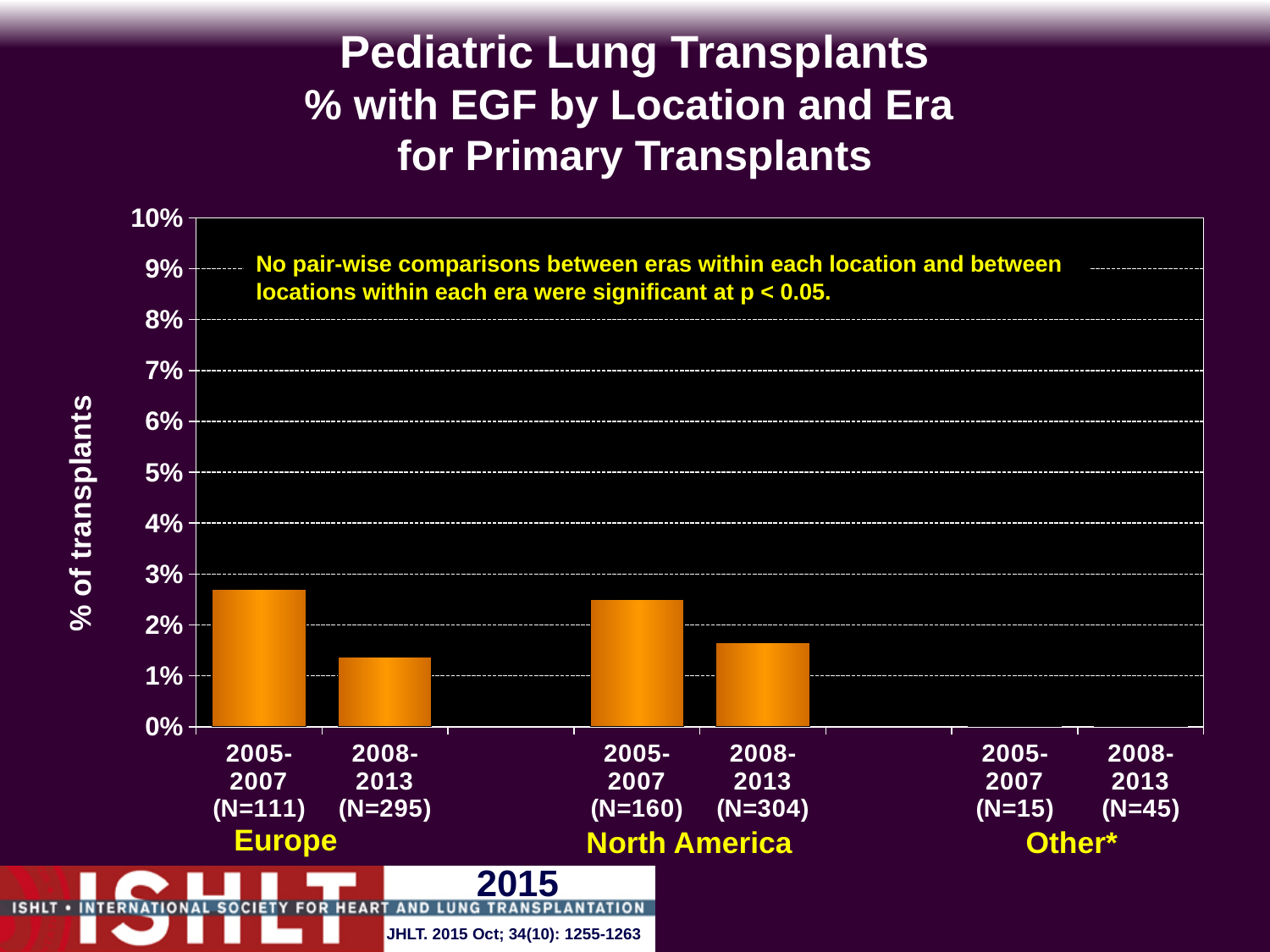
Does the % with EGF rise or fall from the 2005-2007 era to the 2008-2013 era in Europe? fall Is the value for North America 2005-2007 greater or less than 3%? less Which location shows no visible bars (0%) for both eras? Other* How many bars (era-location categories) are shown along the x axis? 6 Which is larger: the value for Europe 2005-2007 or Europe 2008-2013? Europe 2005-2007 Is the value for Europe 2008-2013 greater or less than 2%? less Is the value for Europe 2005-2007 greater or less than 2%? greater What is the label on the y axis? % of transplants Which is larger: the value for North America 2005-2007 or North America 2008-2013? North America 2005-2007 What is the N for the North America 2008-2013 group? N=304 What kind of chart is shown on the slide? bar chart